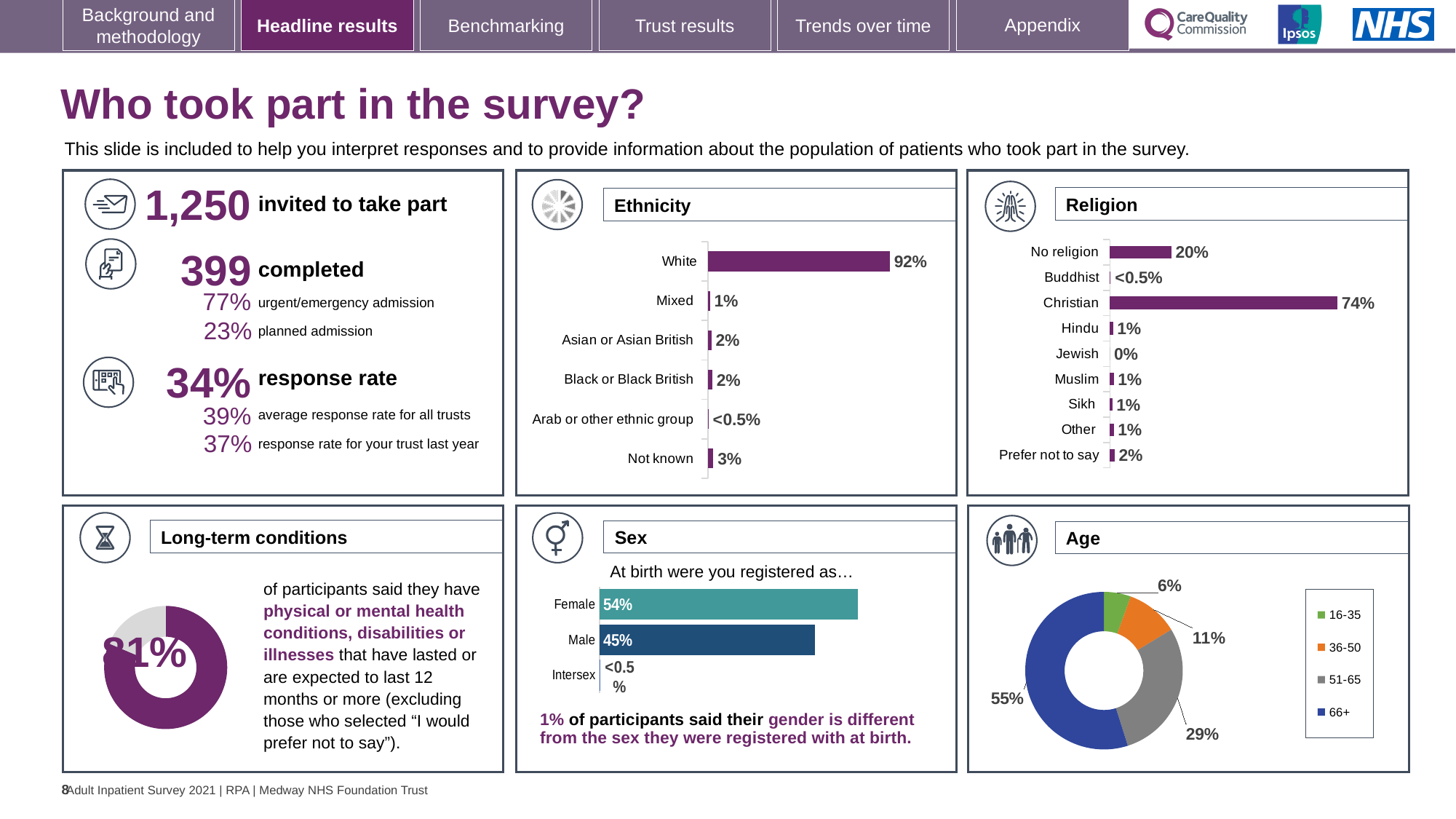
How many religion categories are listed in the Religion chart? 9 In the Sex chart, which is larger, the Female or the Male percentage? Female In the Age chart, what share of participants were aged 66+? 55% In the Religion chart, what is the difference between the Christian and No religion percentages? 54 percentage points In the Ethnicity chart, which ethnic group has the highest percentage? White What type of chart is the Age chart? Pie (donut) chart In the Religion chart, what percentage of participants were Christian? 74% In the Long-term conditions chart, what percentage of participants said they have a long-term condition? 81% How many ethnic group categories are shown in the Ethnicity chart? 6 In the Ethnicity chart, what percentage of participants were White? 92% In the Sex chart, what is the difference between the Female and Male percentages? 9 percentage points How many age groups does the legend of the Age chart list? 4